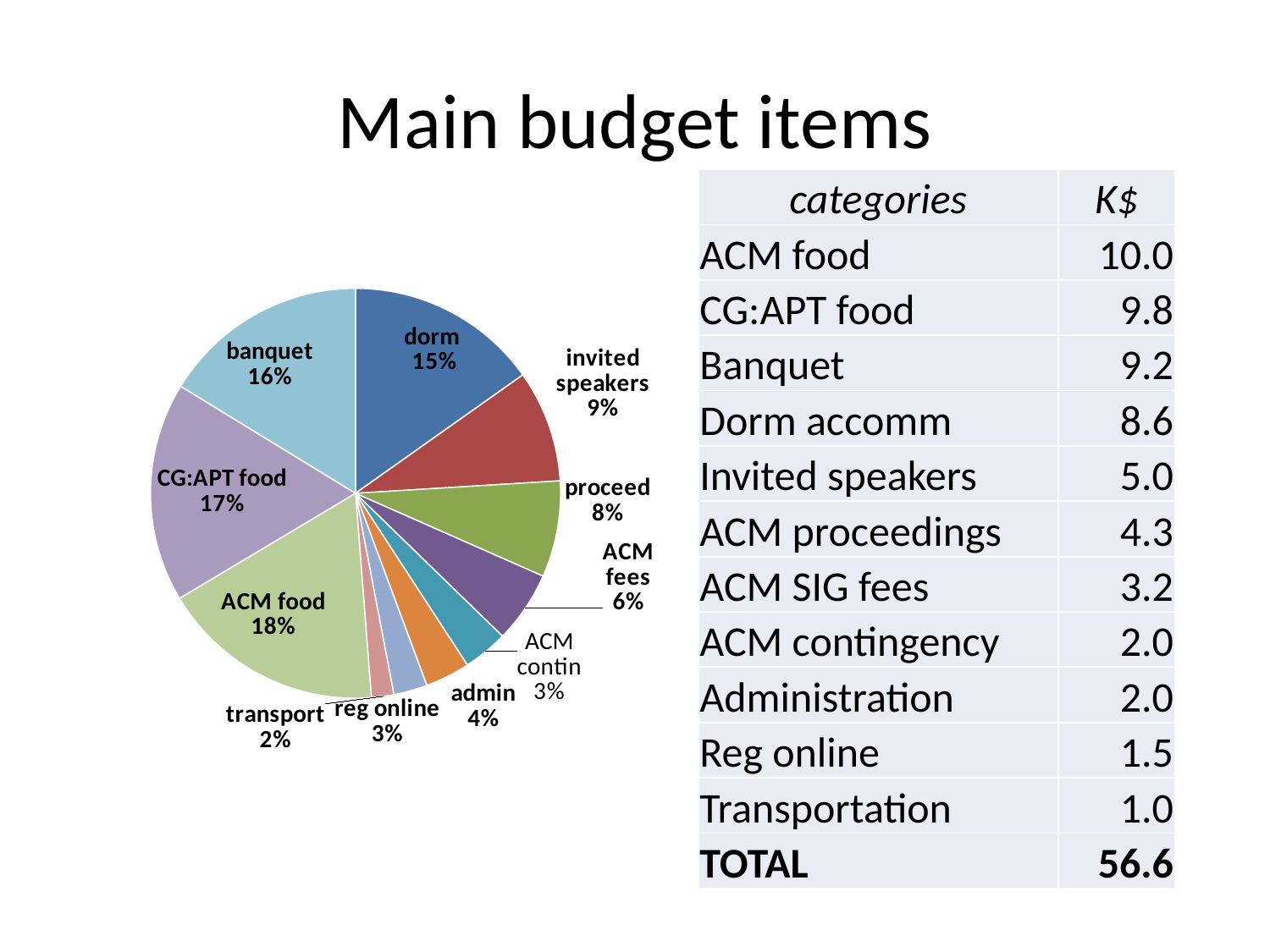
In the pie chart, what is the difference in percentage points between the ACM food slice and the dorm slice? 3 Which slice of the pie chart is the largest? ACM food In the pie chart, which is larger: the CG:APT food slice or the banquet slice? CG:APT food What percentage does the ACM fees slice show in the pie chart? 6% In the pie chart, what is the difference in percentage points between the proceed slice and the admin slice? 4 What percentage is shown for invited speakers in the pie chart? 9% Which slice of the pie chart is the smallest? transport What share of the pie chart does the dorm slice represent? 15% How many slices does the pie chart have? 11 What kind of chart is shown on the slide? pie chart What is the title of the slide containing the pie chart? Main budget items What percentage is shown for the banquet slice in the pie chart? 16%